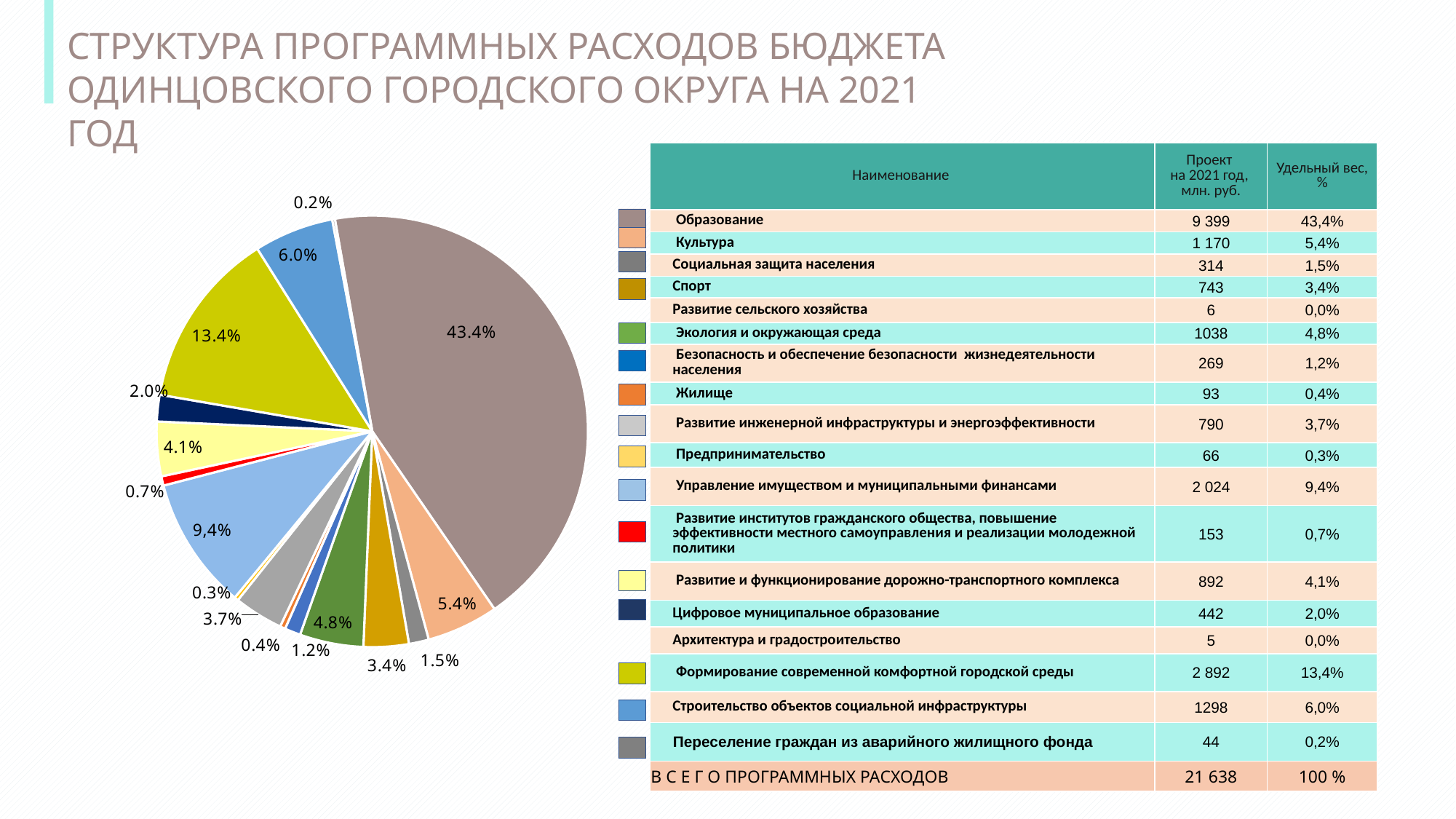
What is the smallest percentage label shown on the pie chart? 0.2% What is the difference in percentage points between the 13.4% slice and the 6.0% slice of the pie chart? 7.4 Which slice of the pie chart is larger: the one labeled 9,4% or the one labeled 5.4%? 9,4% What kind of chart is shown on the left of the slide? pie chart What percentage is shown on the orange slice of the pie chart (Культура)? 5.4% What year does the slide title say the budget programme expenditure structure refers to? 2021 What is the difference in percentage points between the largest slice (43.4%) and the 13.4% slice of the pie chart? 30.0 How many percentage labels are shown on the pie chart? 16 Which slice of the pie chart is larger: the one labeled 4.8% or the one labeled 4.1%? 4.8% What percentage label is shown on the largest slice of the pie chart? 43.4% What percentage is shown on the yellow-green slice of the pie chart (Формирование современной комфортной городской среды)? 13.4% What percentage is shown on the light blue slice of the pie chart (Управление имуществом и муниципальными финансами)? 9,4%